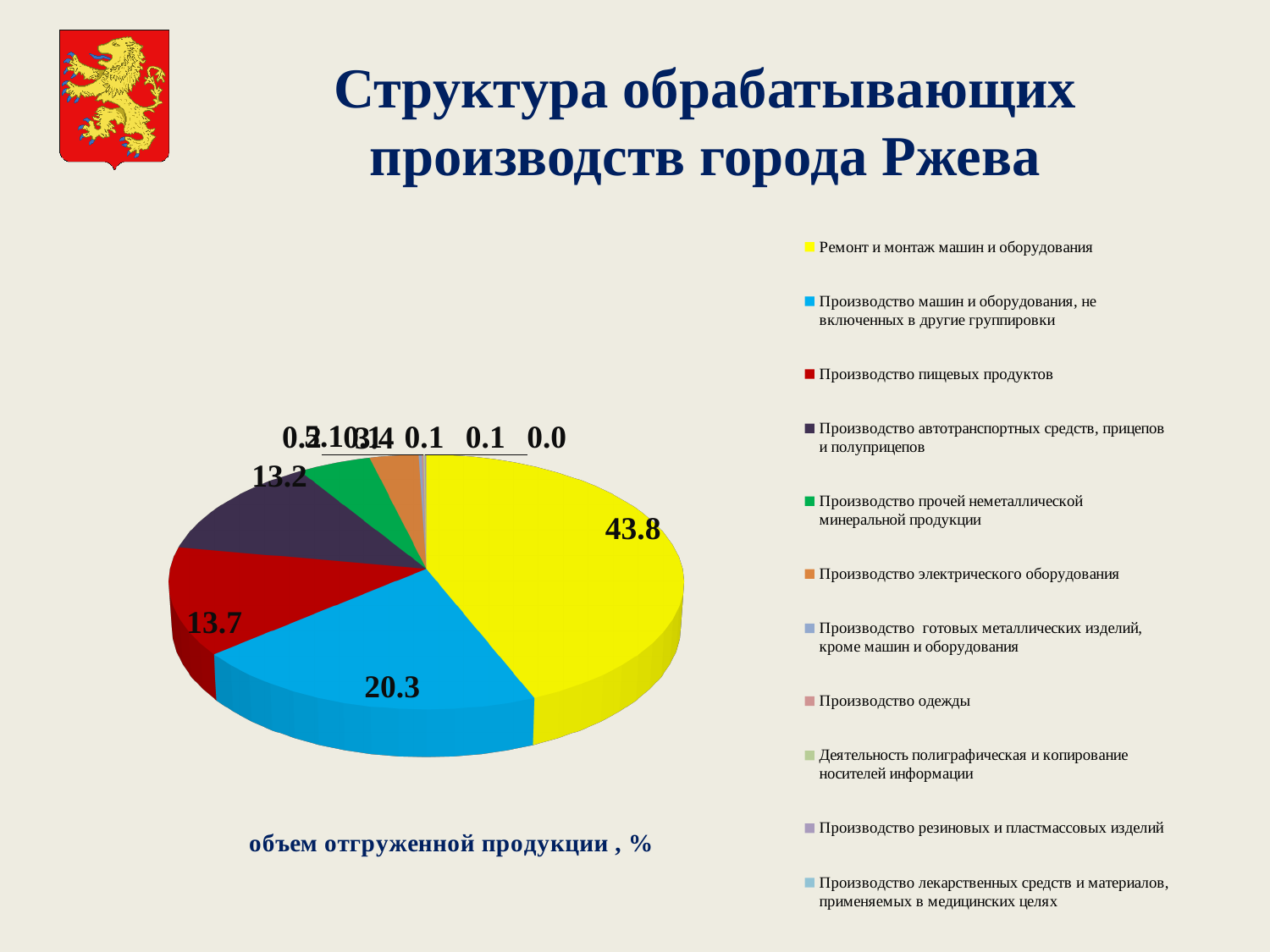
What is the value for Ремонт и монтаж машин и оборудования? 43.8 How many categories does the legend list? 11 What is the value for Производство машин и оборудования, не включенных в другие группировки? 20.3 What is the difference between the values for Производство пищевых продуктов and Производство автотранспортных средств, прицепов и полуприцепов? 0.5 Which category has the largest slice of the pie? Ремонт и монтаж машин и оборудования What caption is printed below the pie chart? объем отгруженной продукции , % What kind of chart is shown on the slide? pie chart What colour is the largest slice of the pie? yellow What is the value for Производство пищевых продуктов? 13.7 Which is larger: the value for Производство пищевых продуктов or the value for Производство машин и оборудования, не включенных в другие группировки? Производство машин и оборудования, не включенных в другие группировки What is the value for Производство автотранспортных средств, прицепов и полуприцепов? 13.2 What is the difference between the values for Ремонт и монтаж машин и оборудования and Производство машин и оборудования, не включенных в другие группировки? 23.5